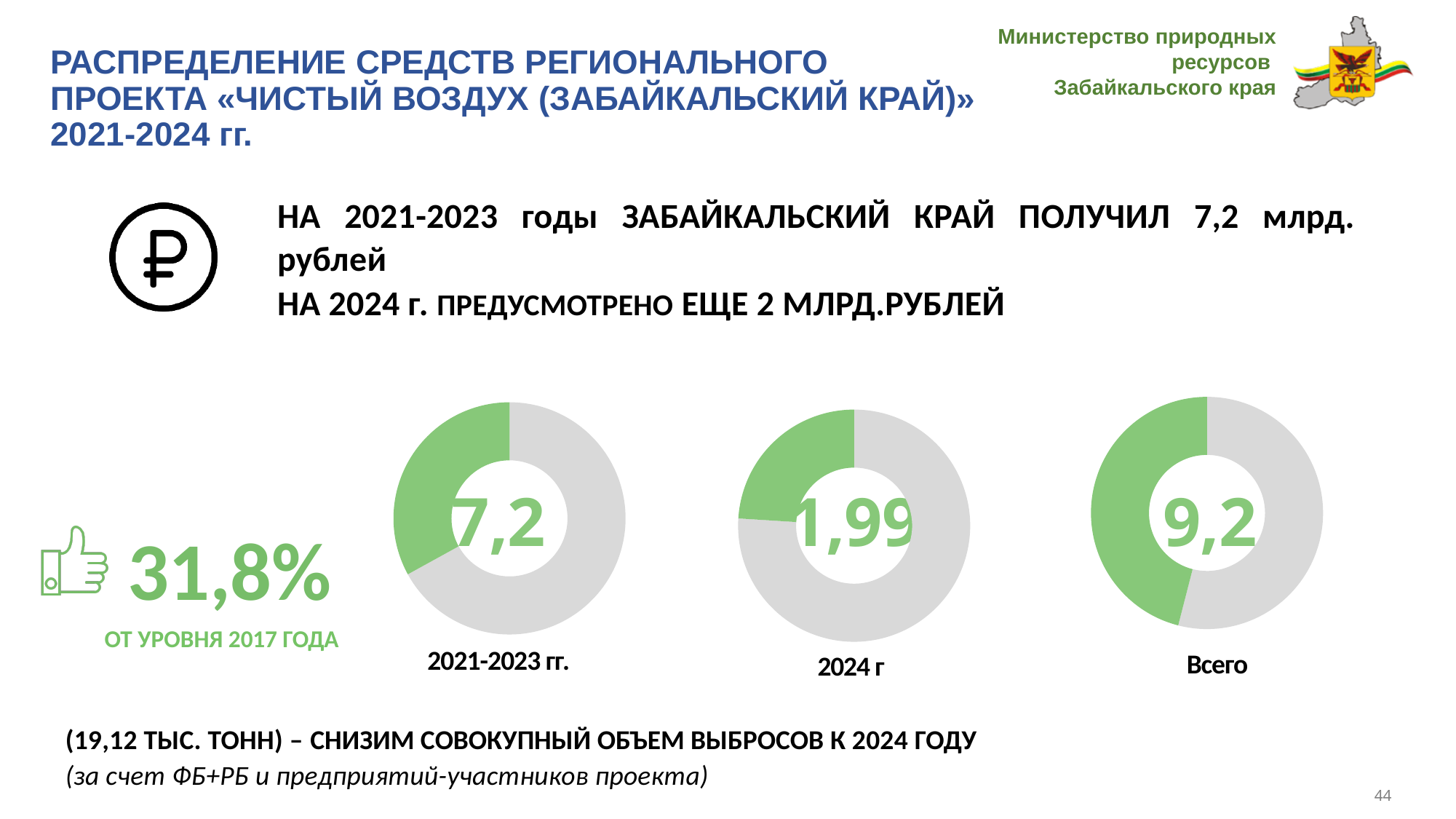
What value is shown in the centre of the donut chart labelled "Всего"? 9,2 What colour is used for the filled segment in each of the three donut charts? Green What value is shown in the centre of the donut chart labelled "2021-2023 гг."? 7,2 What value is shown in the centre of the donut chart labelled "2024 г"? 1,99 How many donut charts are shown on the slide? 3 Which donut chart has the largest green (filled) share of its ring? Всего What is the difference between the centre value of the "Всего" chart and the "2021-2023 гг." chart? 2 Which donut chart has the smallest green (filled) share of its ring? 2024 г What kind of charts are the three charts in the middle of the slide? Donut (pie) charts Which donut chart shows the largest centre value? Всего Which donut chart shows the smallest centre value? 2024 г Which is larger, the centre value of the "2021-2023 гг." chart or the "2024 г" chart? 2021-2023 гг.